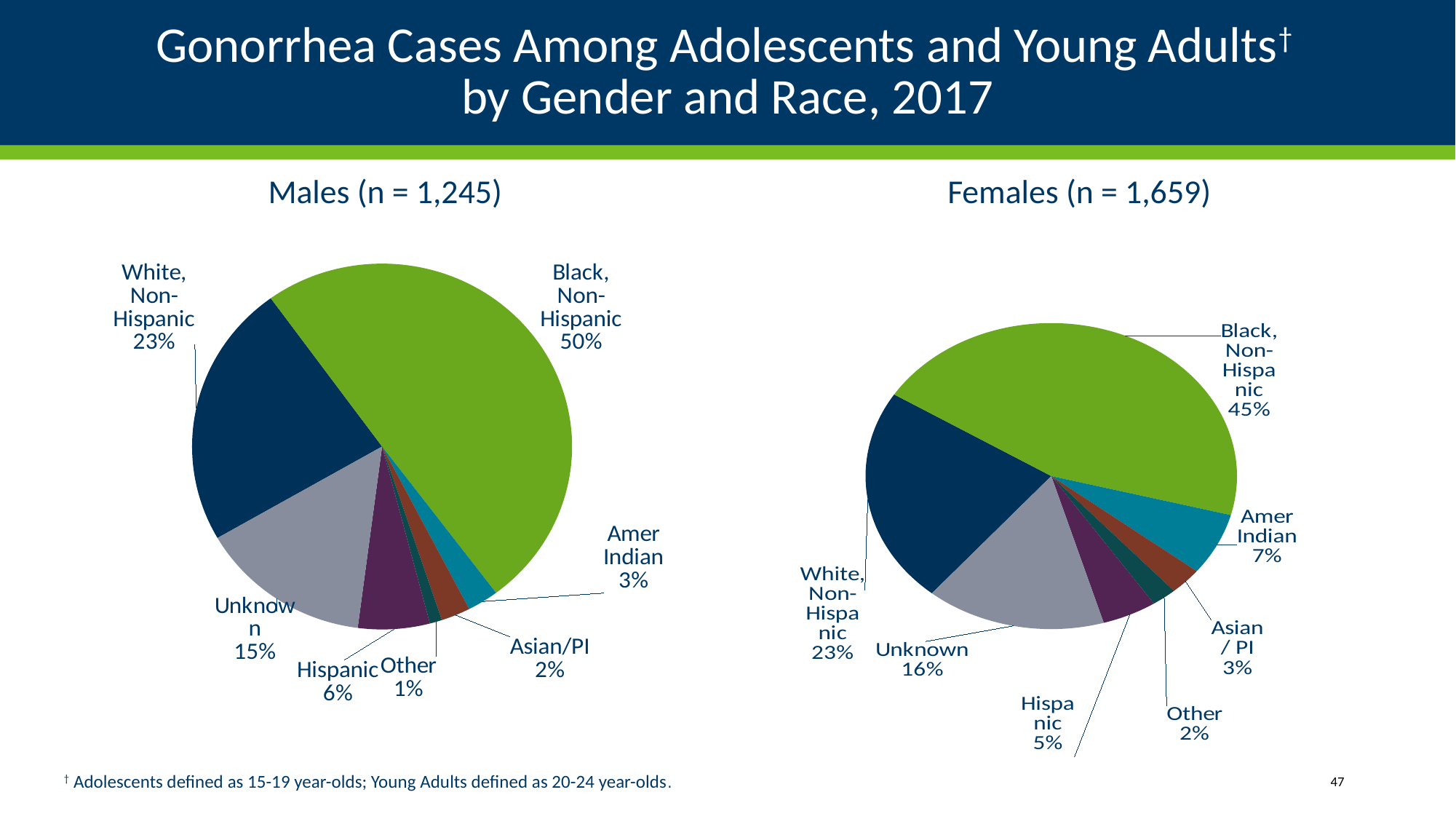
What is the sample size (n) shown in the title of the Females chart? 1,659 In the Females (n = 1,659) pie chart, what share of cases is Black, Non-Hispanic? 45% In the Males pie chart, which race category has the smallest slice? Other How many race categories are shown in the Females pie chart? 7 In the Males pie chart, which race category has the largest slice? Black, Non-Hispanic What is the difference between the Black, Non-Hispanic share in the Males chart and in the Females chart? 5 percentage points What type of chart is used on this slide? Pie chart In the Females pie chart, which race category has the largest slice? Black, Non-Hispanic Is the Hispanic share larger in the Males chart or the Females chart? Males In the Females pie chart, what percentage is labelled Amer Indian? 7% In the Males pie chart, what percentage is labelled Unknown? 15% In the Males (n = 1,245) pie chart, what share of cases is Black, Non-Hispanic? 50%